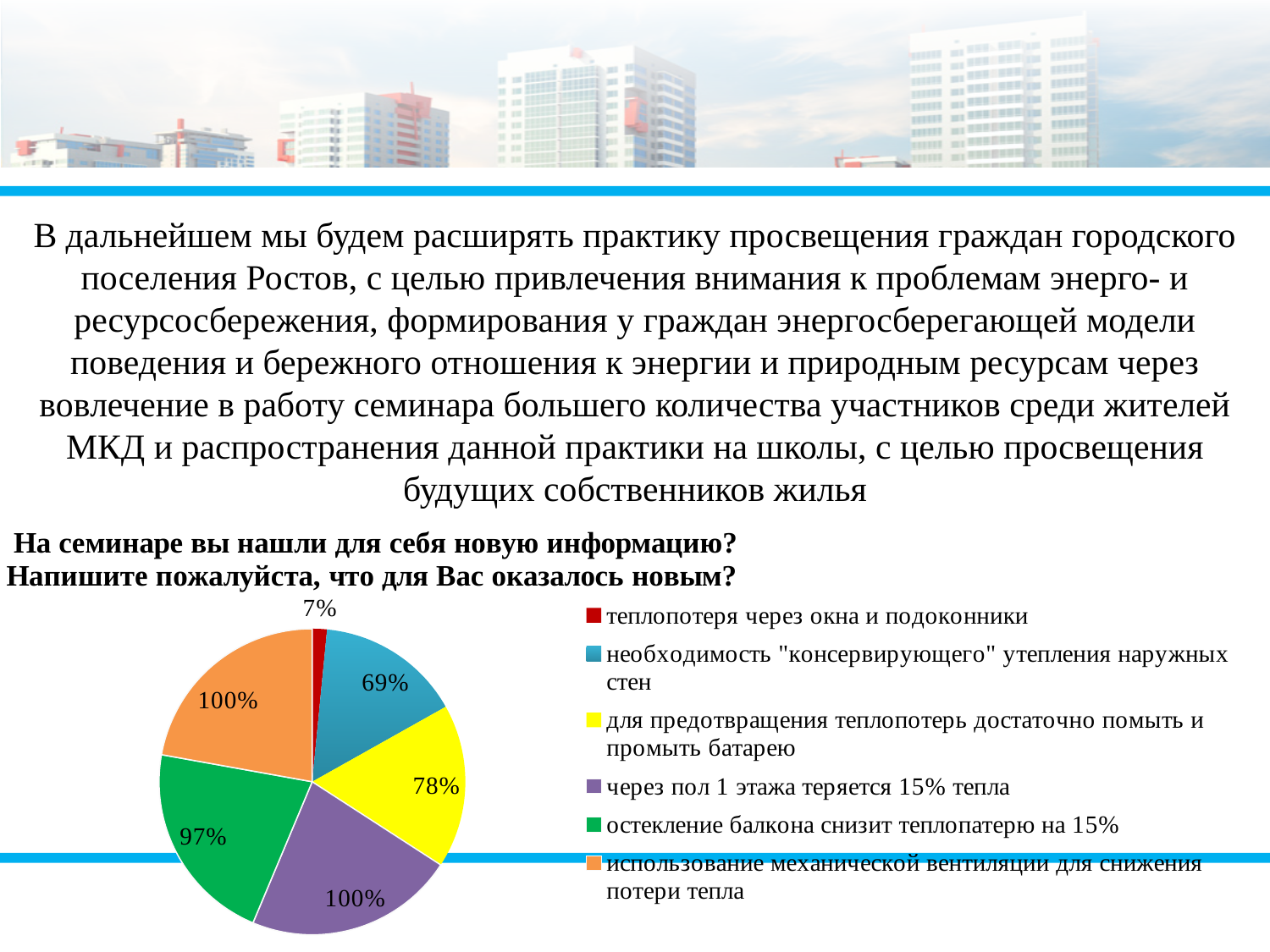
What is the difference between the values for "для предотвращения теплопотерь достаточно помыть и промыть батарею" and "необходимость "консервирующего" утепления наружных стен"? 9% How many slices does the pie chart have? 6 What value is shown for the slice "через пол 1 этажа теряется 15% тепла"? 100% What colour is the slice for "использование механической вентиляции для снижения потери тепла"? orange How many entries does the legend of the pie chart list? 6 What value is shown for the slice "для предотвращения теплопотерь достаточно помыть и промыть батарею"? 78% Which slice of the pie chart has the lowest value? теплопотеря через окна и подоконники What kind of chart is shown on the slide? pie chart What value is shown for the slice "необходимость "консервирующего" утепления наружных стен"? 69% What value is shown for the slice "остекление балкона снизит теплопатерю на 15%"? 97% Which is larger: the value for "необходимость "консервирующего" утепления наружных стен" or for "для предотвращения теплопотерь достаточно помыть и промыть батарею"? для предотвращения теплопотерь достаточно помыть и промыть батарею What value is shown for the slice "теплопотеря через окна и подоконники"? 7%